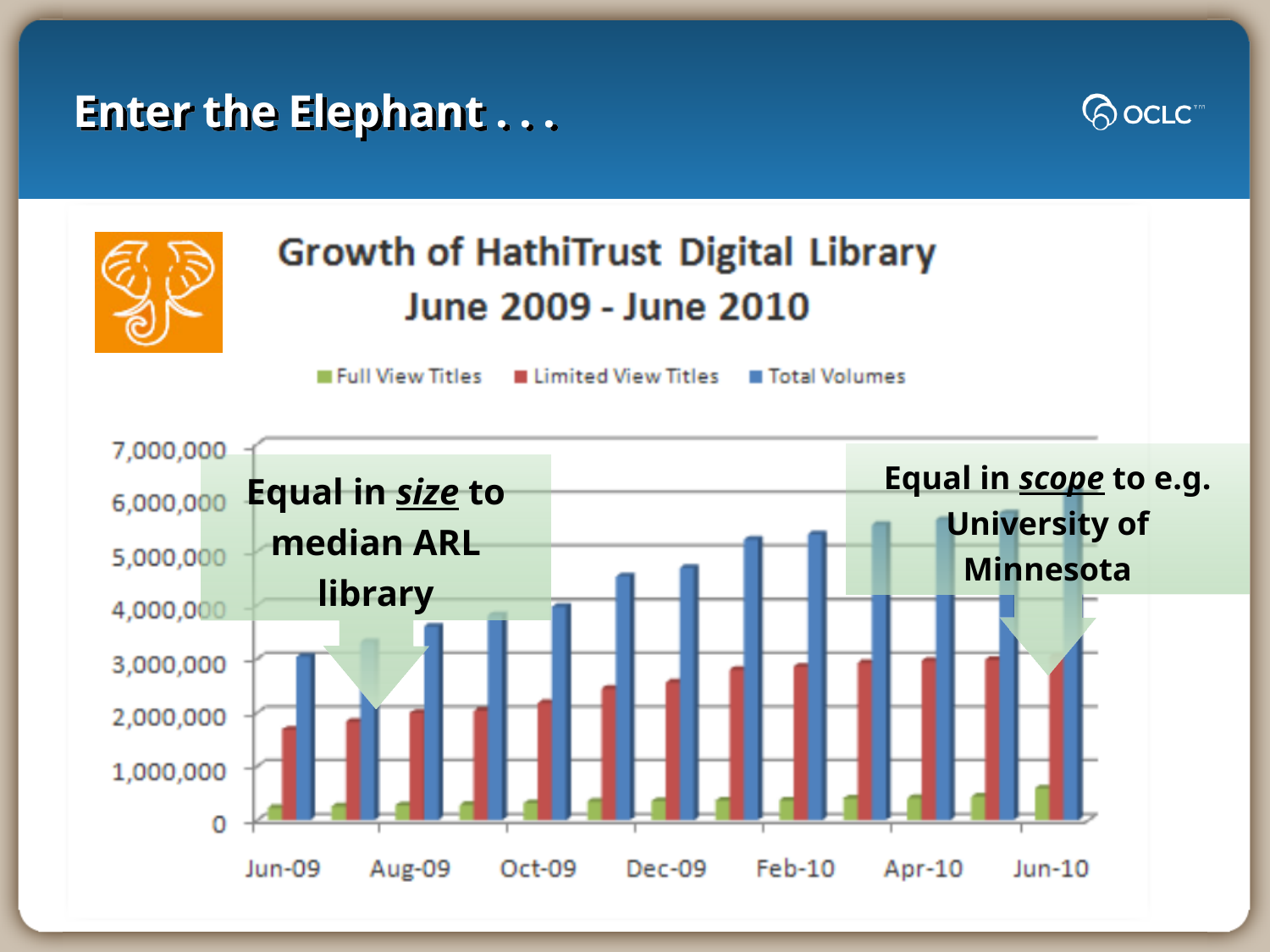
How many month labels are shown on the x axis of the chart? 7 Which series is shown in blue in the chart legend? Total Volumes Is the Total Volumes value for Feb-10 greater or less than 5,000,000? greater In which month is Total Volumes lowest? Jun-09 Is the Full View Titles value for Jun-10 greater or less than 1,000,000? less What is the title of the chart? Growth of HathiTrust Digital Library June 2009 - June 2010 What kind of chart is shown on the slide? Bar chart How many series does the chart legend list? 3 In Dec-09, which is larger: Total Volumes or Limited View Titles? Total Volumes In which month is Total Volumes highest? Jun-10 Do the Total Volumes values rise or fall from Jun-09 to Jun-10? Rise Is the Limited View Titles value for Jun-09 greater or less than 2,000,000? less